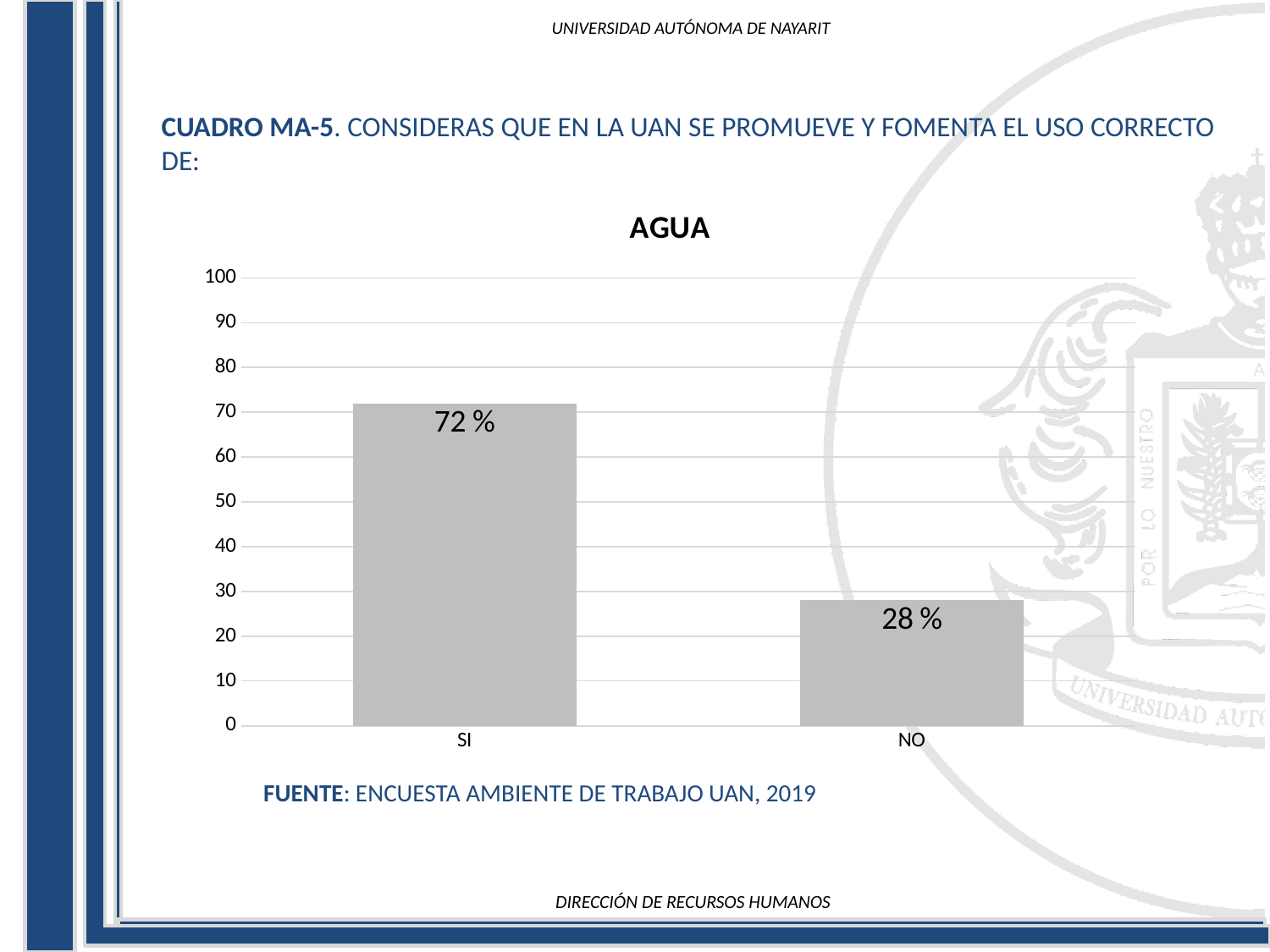
How many categories are shown on the x axis? 2 Is the value for SI greater or less than 50? greater What is the value for NO? 28 % Which category has the highest value? SI Is the value for NO greater or less than 30? less What is the title of the chart? AGUA What is the highest value shown on the y axis? 100 Which category has the lowest value? NO What is the difference between the values for SI and NO? 44 % What kind of chart is shown? bar chart What is the value for SI? 72 % Which is larger, the value for SI or the value for NO? SI